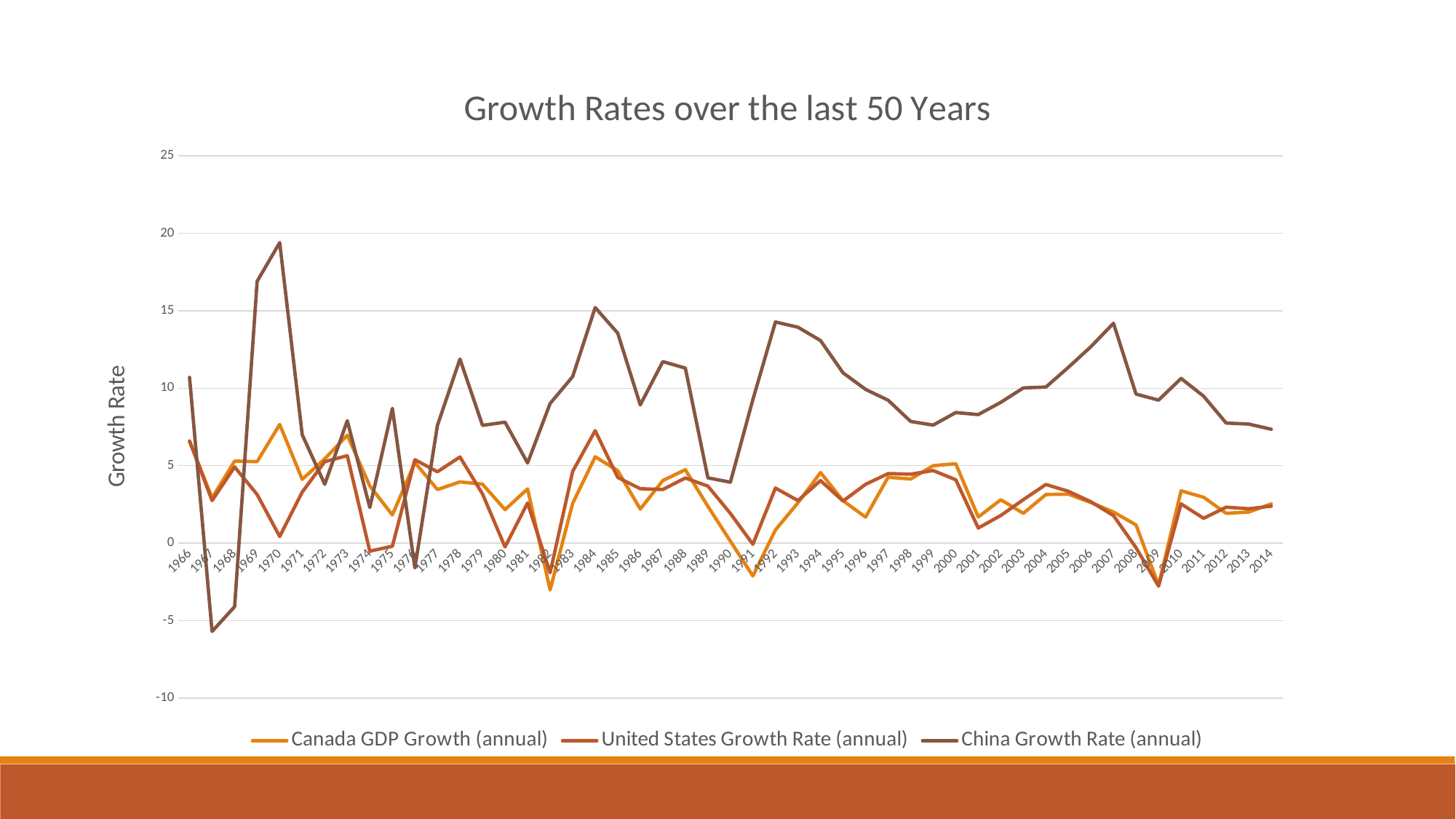
Is the China Growth Rate (annual) value for 1992 greater or less than 10? greater What kind of chart is shown on the slide? line chart Which is larger for China Growth Rate (annual): the value in 1988 or the value in 1989? 1988 Does the China Growth Rate (annual) series rise or fall from 2007 to 2009? fall How many series does the legend list? 3 In which year does the China Growth Rate (annual) series reach its highest value? 1970 Which series has the highest value in 1970? China Growth Rate (annual) What is the title of the chart? Growth Rates over the last 50 Years How many years are plotted along the x axis? 49 Is the China Growth Rate (annual) value for 1970 greater or less than 15? greater Is the Canada GDP Growth (annual) value for 2009 greater or less than 0? less